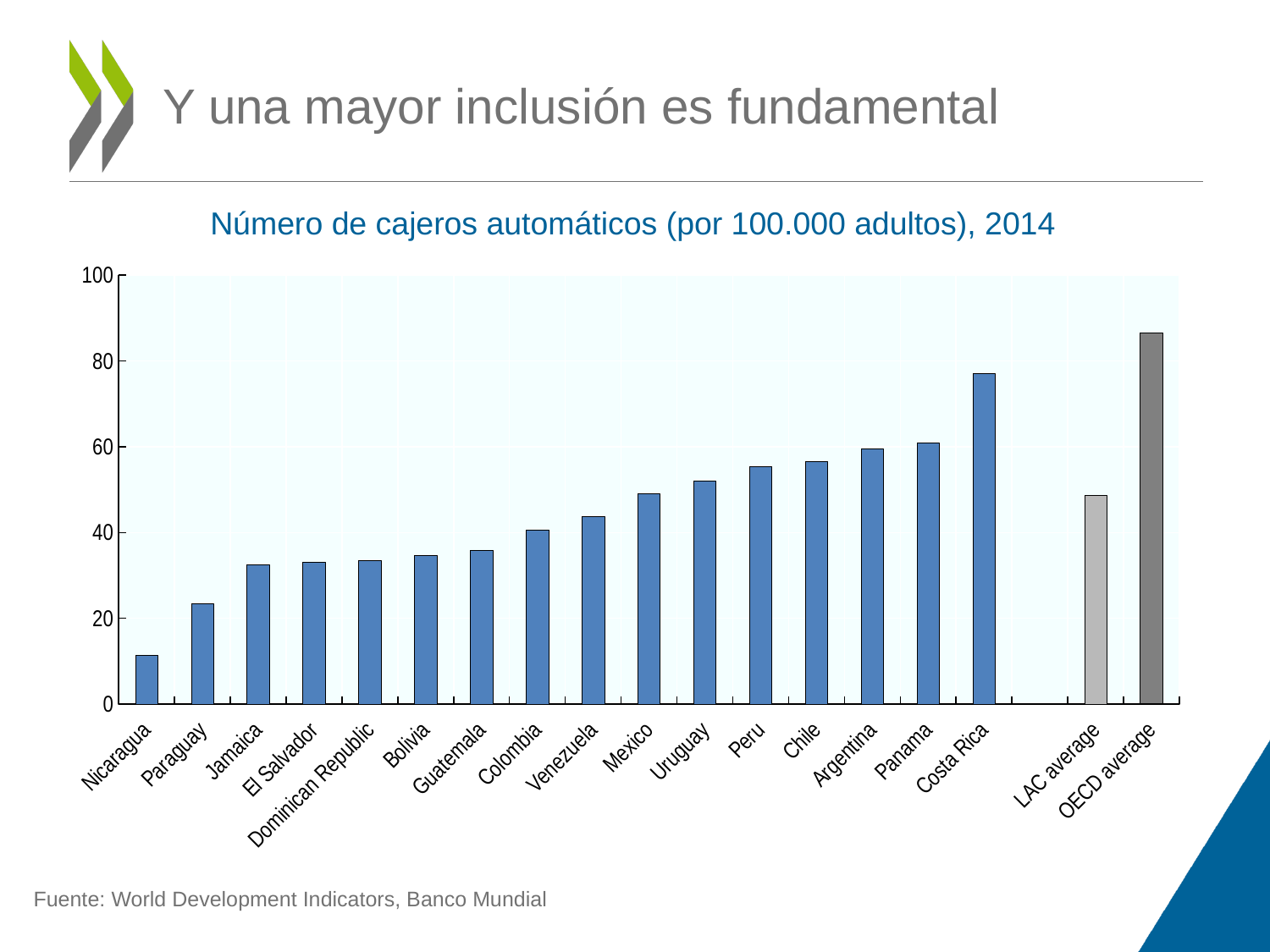
What kind of chart is shown on the slide? bar chart Is the value for OECD average greater or less than 80? greater How many bars are plotted in the chart? 18 Is the value for Nicaragua greater or less than 20? less Which country has the lowest number of ATMs per 100,000 adults? Nicaragua Is the value for Costa Rica greater or less than 60? greater Which category has the highest bar in the chart? OECD average Which country (excluding the averages) has the highest number of ATMs per 100,000 adults? Costa Rica Do the country values rise or fall from Nicaragua to Costa Rica along the x axis? rise Which is larger, the value for LAC average or the value for OECD average? OECD average What is the title of the chart? Número de cajeros automáticos (por 100.000 adultos), 2014